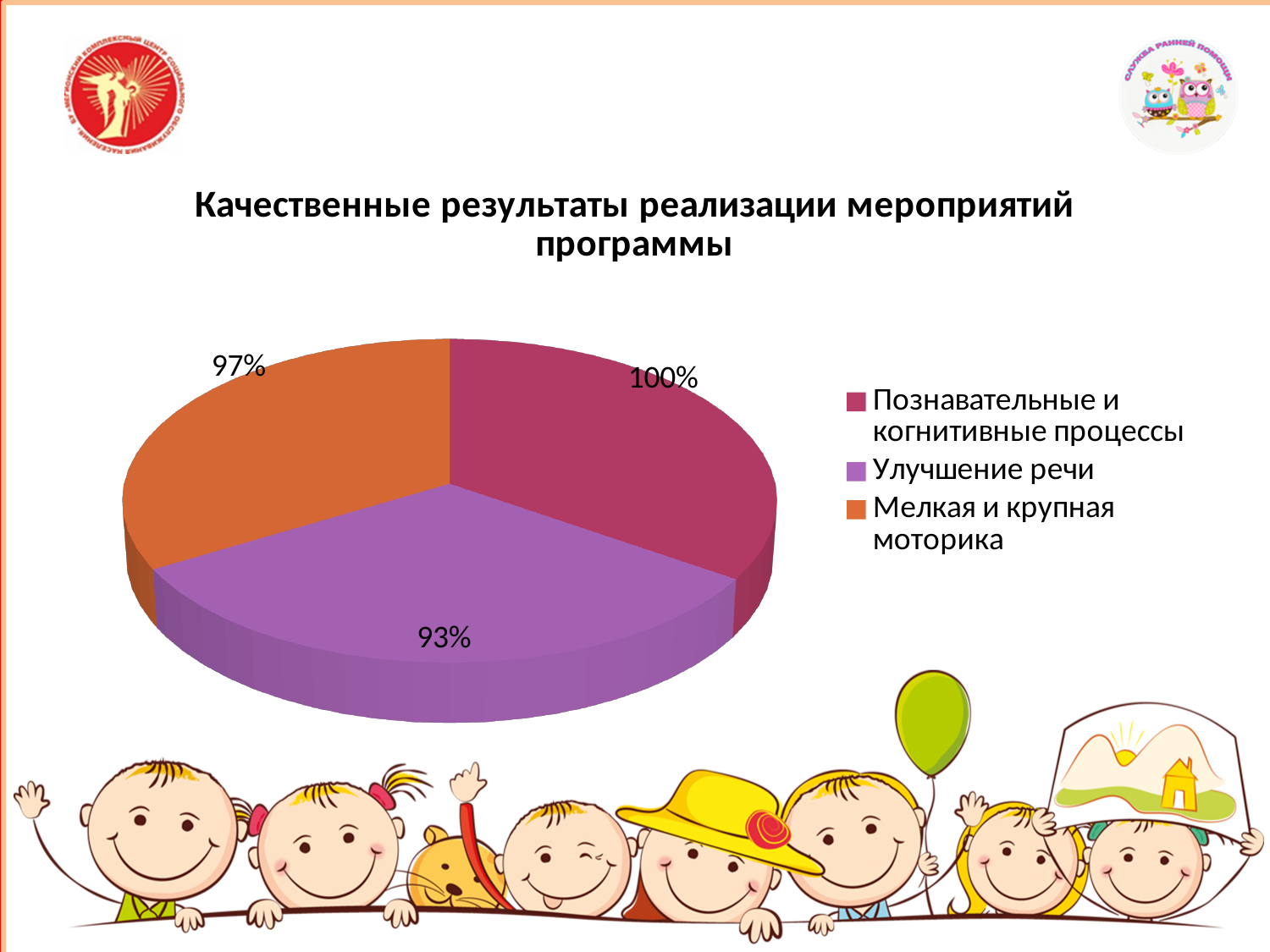
Which colour represents Улучшение речи in the chart? purple What type of chart is shown on the slide? pie chart What value is shown for Мелкая и крупная моторика? 97% What is the difference between the values for Мелкая и крупная моторика and Улучшение речи? 4% Which is larger, the value for Мелкая и крупная моторика or the value for Улучшение речи? Мелкая и крупная моторика What value is shown for Улучшение речи? 93% Which category has the lowest value? Улучшение речи What value is shown for Познавательные и когнитивные процессы? 100% What is the difference between the values for Познавательные и когнитивные процессы and Улучшение речи? 7% What is the title of the chart on the slide? Качественные результаты реализации мероприятий программы How many categories does the pie chart have? 3 Which category has the highest value? Познавательные и когнитивные процессы